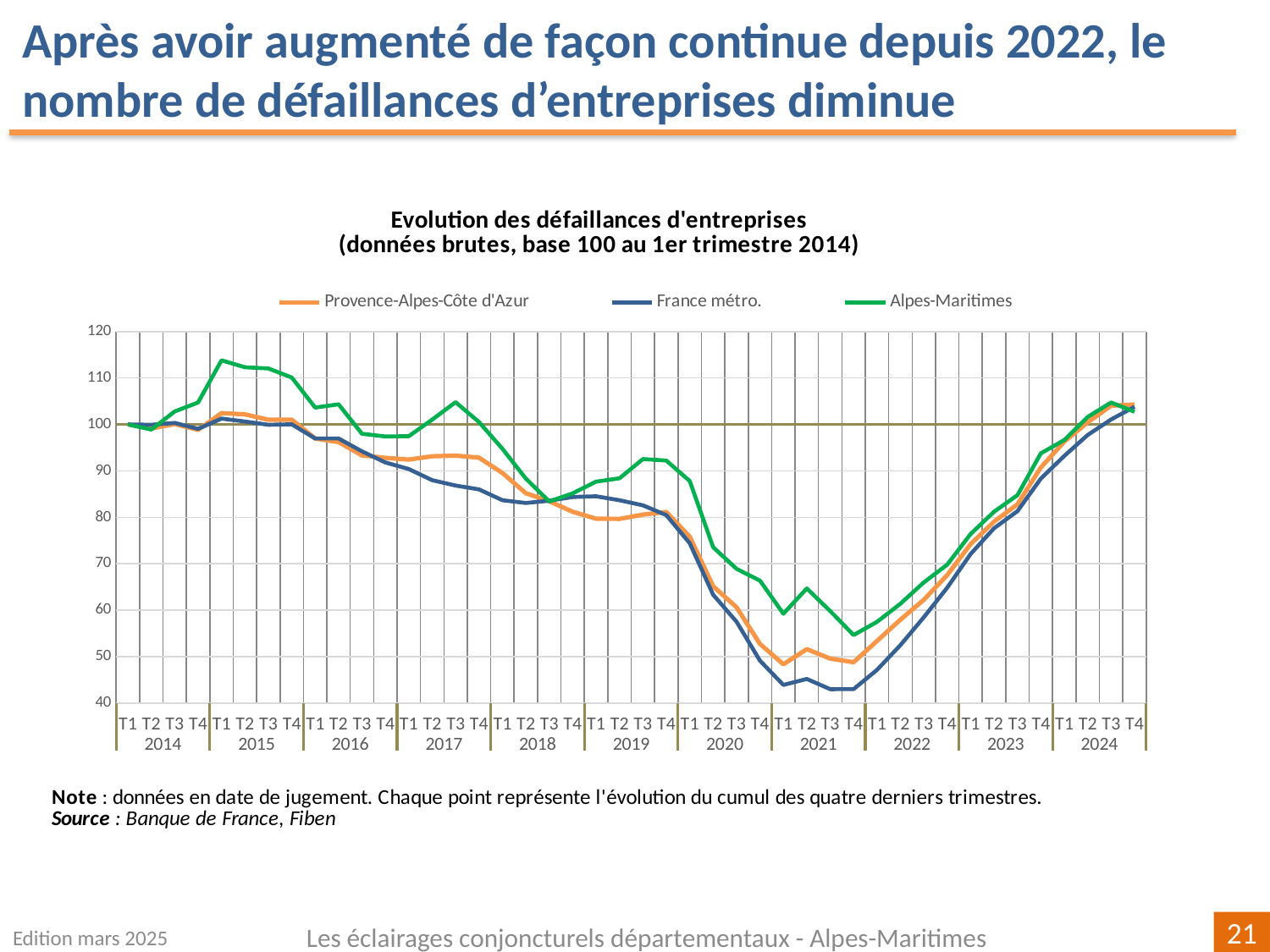
Is the value for Alpes-Maritimes at T3 2017 greater or less than 100? greater How many series does the legend list? 3 Between T1 2019 and T4 2021, do the values for France métro. rise or fall? fall Which series has the lowest value at T4 2021? France métro. Which series has the highest value at T1 2015? Alpes-Maritimes How many years are shown along the x axis? 11 What is the value of each series at T1 2014, the base period? 100 Is the value for France métro. at T4 2021 greater or less than 50? less Which series are listed in the legend? Provence-Alpes-Côte d'Azur, France métro., Alpes-Maritimes What kind of chart is shown on the slide? line chart Is the value for Alpes-Maritimes at T1 2015 greater or less than 110? greater Between T1 2022 and T3 2024, do the values for Provence-Alpes-Côte d'Azur rise or fall? rise